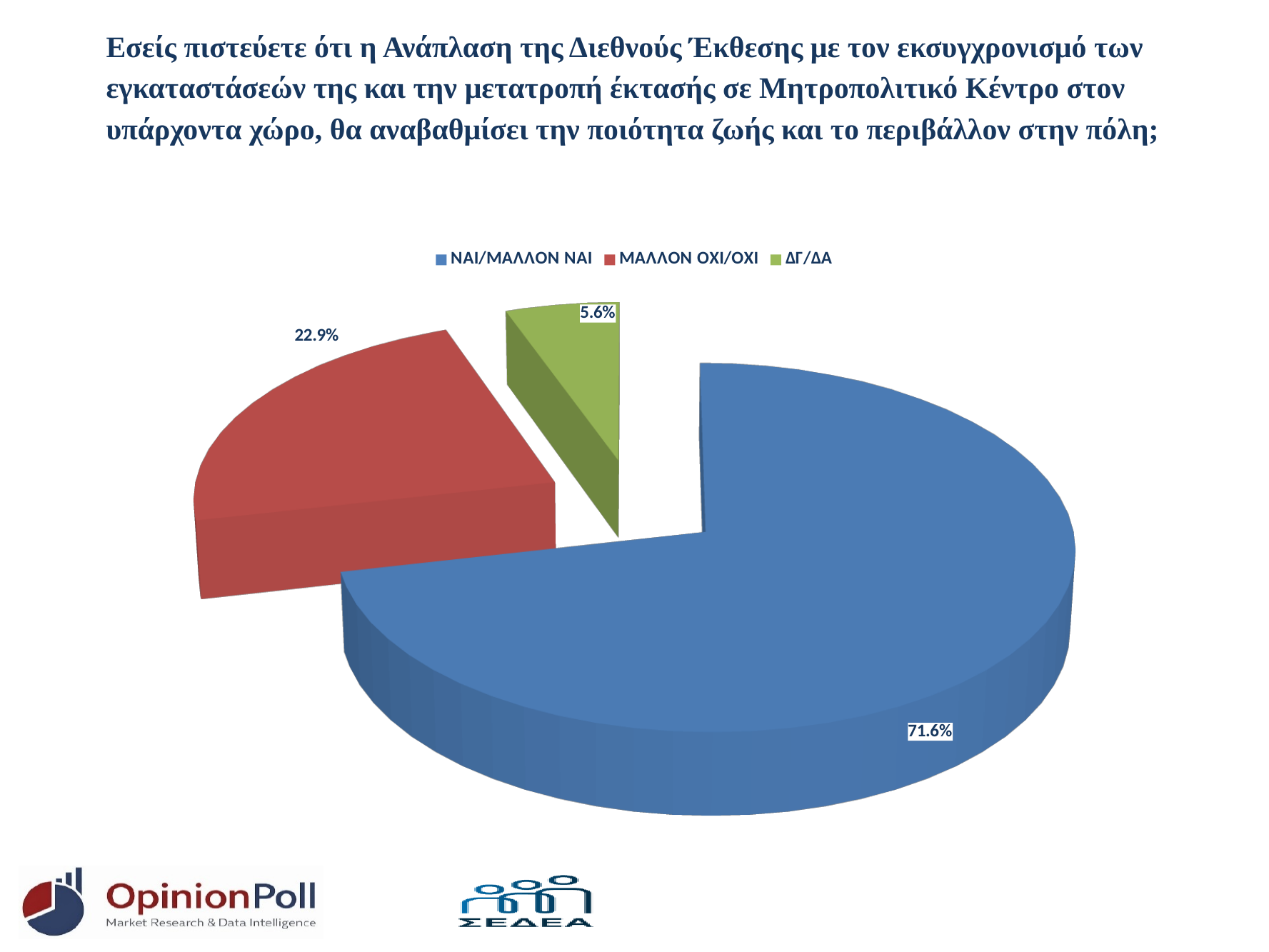
How many entries does the legend list? 3 What percentage of respondents answered ΔΓ/ΔΑ? 5.6% Which response category has the smallest share of the pie? ΔΓ/ΔΑ Which response category has the largest share of the pie? ΝΑΙ/ΜΑΛΛΟΝ ΝΑΙ What colour is the slice for ΔΓ/ΔΑ? Green What percentage of respondents answered ΝΑΙ/ΜΑΛΛΟΝ ΝΑΙ? 71.6% What kind of chart is shown on the slide? Pie chart Which is larger, the share for ΜΑΛΛΟΝ ΟΧΙ/ΟΧΙ or the share for ΔΓ/ΔΑ? ΜΑΛΛΟΝ ΟΧΙ/ΟΧΙ What percentage of respondents answered ΜΑΛΛΟΝ ΟΧΙ/ΟΧΙ? 22.9% How many slices does the pie chart have? 3 What is the difference in percentage points between ΜΑΛΛΟΝ ΟΧΙ/ΟΧΙ and ΔΓ/ΔΑ? 17.3 What is the difference in percentage points between ΝΑΙ/ΜΑΛΛΟΝ ΝΑΙ and ΜΑΛΛΟΝ ΟΧΙ/ΟΧΙ? 48.7